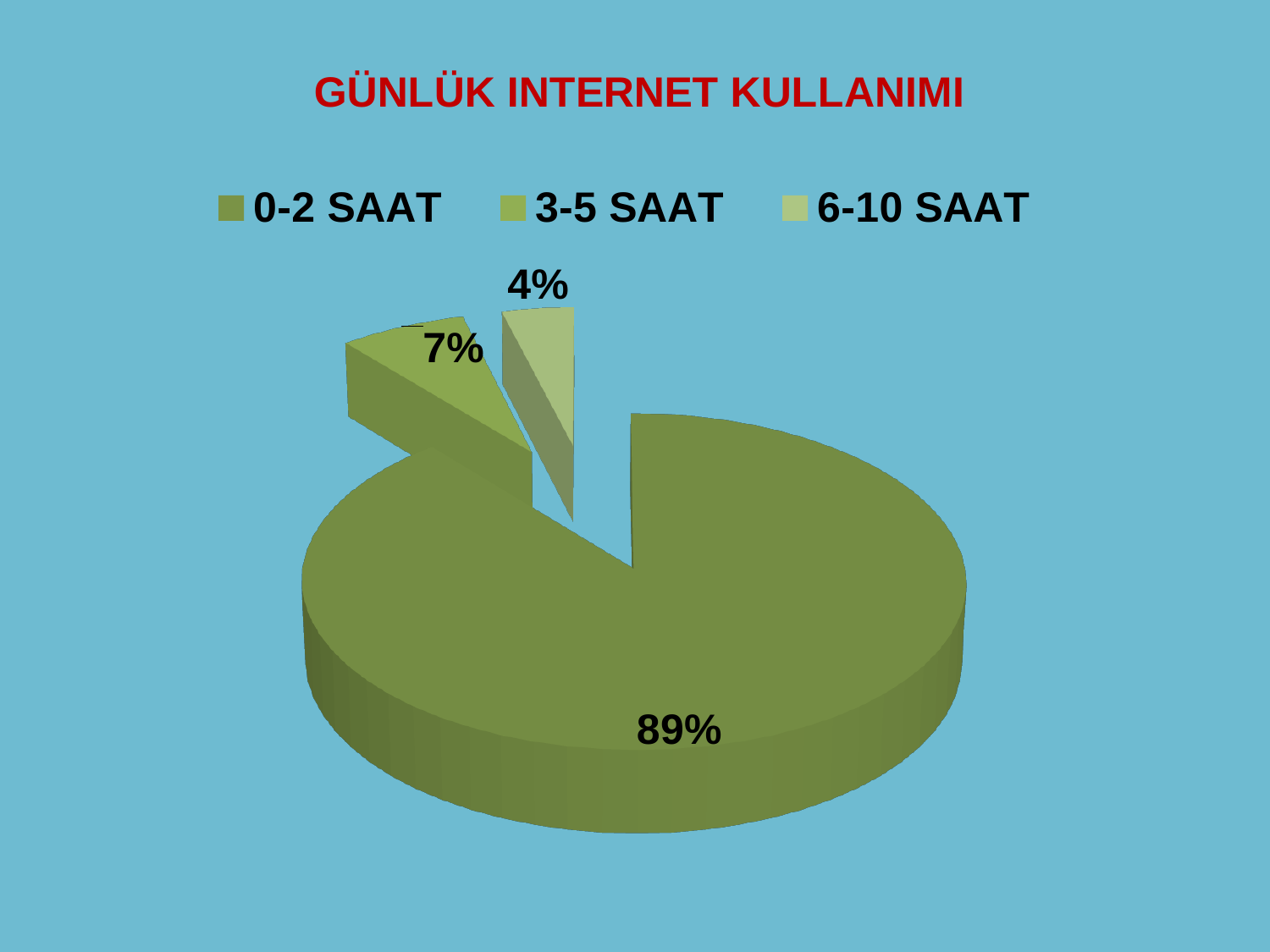
How many categories does the pie chart show? 3 What is the difference in percentage points between the 3-5 SAAT slice and the 6-10 SAAT slice? 3 What is the title of the chart? GÜNLÜK INTERNET KULLANIMI Which category has the smallest slice of the pie? 6-10 SAAT What share of the pie does the 0-2 SAAT slice represent? 89% What kind of chart is shown on the slide? Pie chart What is the difference in percentage points between the 0-2 SAAT slice and the 3-5 SAAT slice? 82 What share of the pie does the 6-10 SAAT slice represent? 4% Which category has the largest slice of the pie? 0-2 SAAT Which legend entry is listed first? 0-2 SAAT What share of the pie does the 3-5 SAAT slice represent? 7% Which is larger, the 3-5 SAAT slice or the 6-10 SAAT slice? 3-5 SAAT